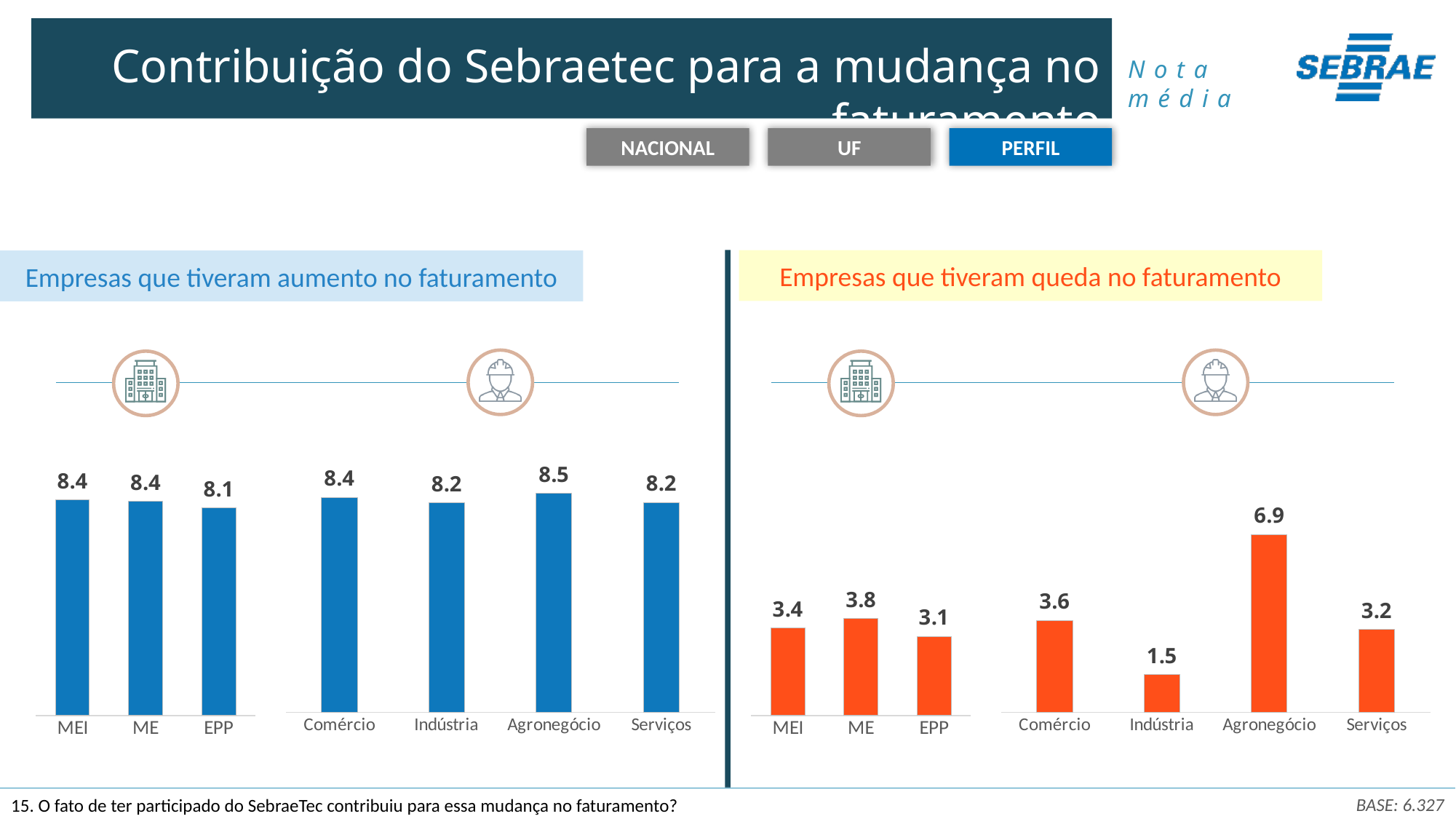
In the 'Empresas que tiveram aumento no faturamento' panel, what is the value for Agronegócio? 8.5 What is the difference between the Agronegócio value in the 'aumento no faturamento' panel and the Agronegócio value in the 'queda no faturamento' panel? 1.6 In the 'Empresas que tiveram queda no faturamento' panel, which sector (Comércio, Indústria, Agronegócio, Serviços) has the highest value? Agronegócio In the 'Empresas que tiveram queda no faturamento' panel, which sector (Comércio, Indústria, Agronegócio, Serviços) has the lowest value? Indústria What type of chart is used in the 'Empresas que tiveram queda no faturamento' panel? Bar chart In the 'Empresas que tiveram queda no faturamento' panel, which is larger, the value for MEI or the value for ME? ME In the 'Empresas que tiveram aumento no faturamento' panel, which of MEI, ME and EPP has the lowest value? EPP In the 'Empresas que tiveram queda no faturamento' panel, what is the value for Indústria? 1.5 How many sector categories are shown in the sector chart of the 'Empresas que tiveram aumento no faturamento' panel? 4 In the 'Empresas que tiveram queda no faturamento' panel, what is the difference between the values for Agronegócio and Indústria? 5.4 In the 'Empresas que tiveram queda no faturamento' panel, what is the value for ME? 3.8 In the 'Empresas que tiveram aumento no faturamento' panel, what is the value for EPP? 8.1